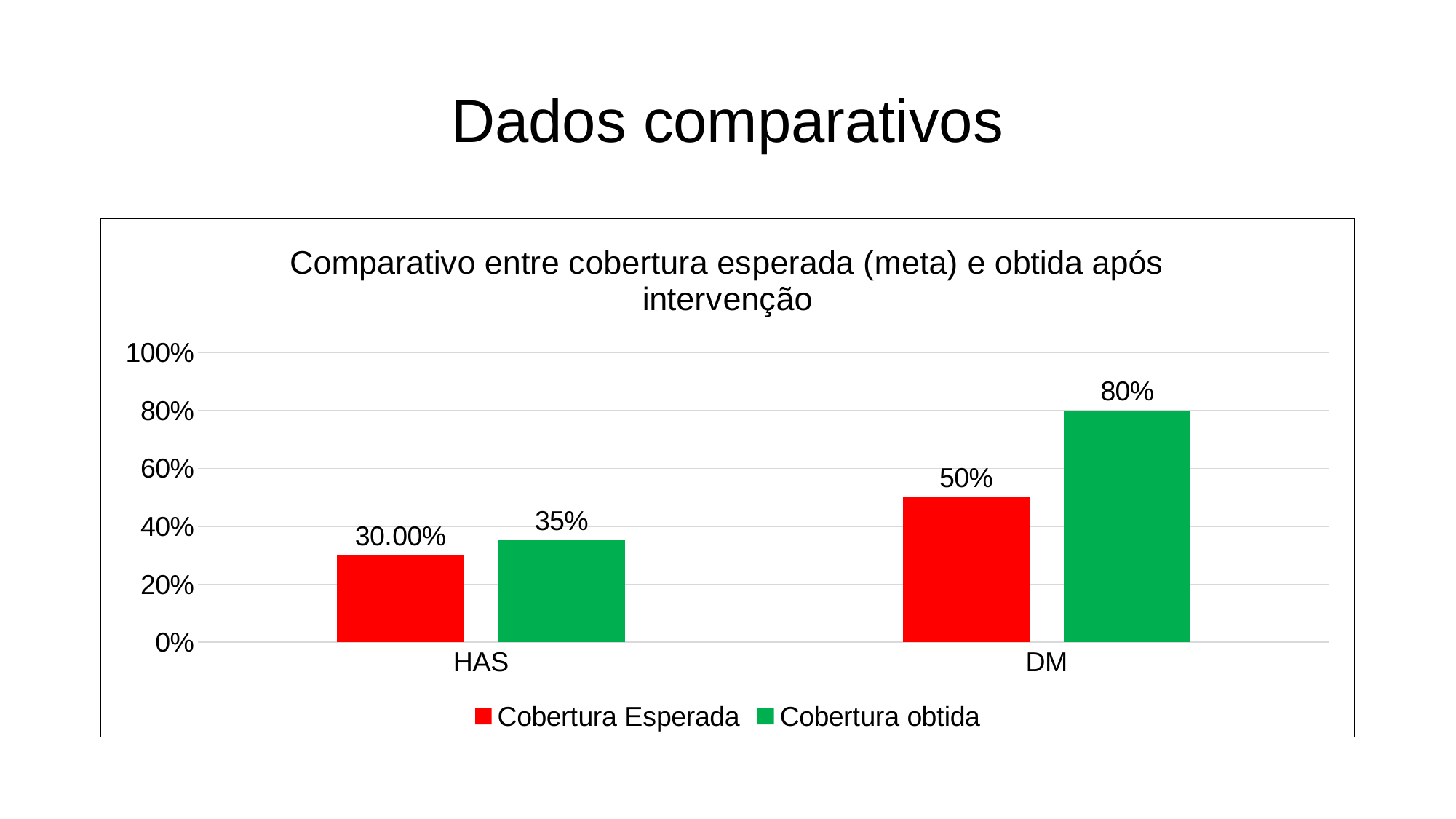
How many categories are shown on the x axis? 2 What is the Cobertura Esperada value for DM? 50% What colour represents the Cobertura obtida series? Green Which category has the highest Cobertura obtida value? DM How many series does the legend list? 2 Which is larger for HAS: Cobertura Esperada or Cobertura obtida? Cobertura obtida What is the difference between Cobertura obtida and Cobertura Esperada for DM? 30% What is the Cobertura obtida value for DM? 80% What kind of chart is shown on the slide? Bar chart What is the Cobertura Esperada value for HAS? 30.00% Which category has the lowest Cobertura Esperada value? HAS What is the Cobertura obtida value for HAS? 35%